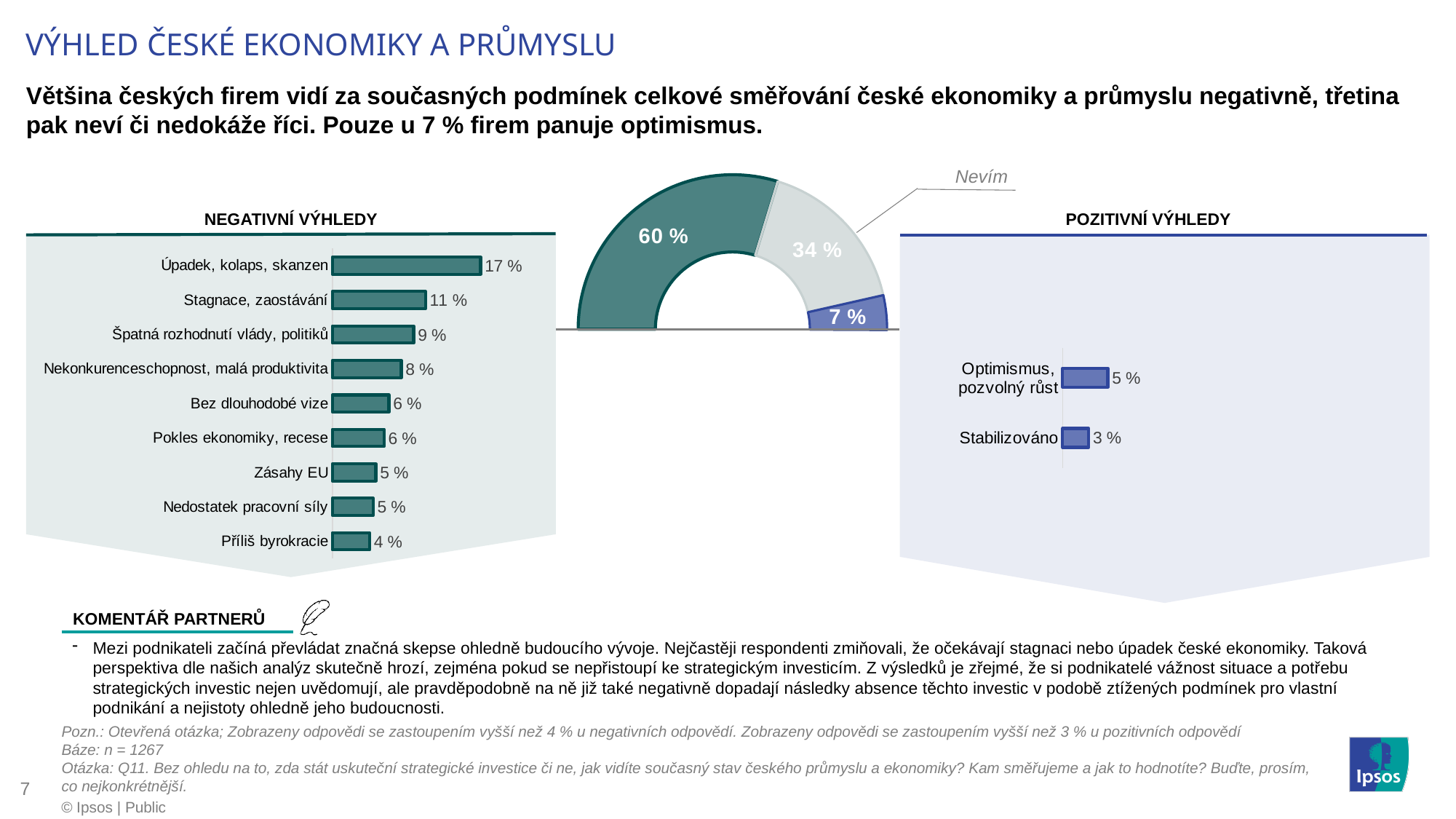
In the semicircle donut chart in the middle of the slide, what share is labelled "Nevím"? 34 % In the POZITIVNÍ VÝHLEDY bar chart, what is the value for "Stabilizováno"? 3 % In the POZITIVNÍ VÝHLEDY bar chart, how many categories are shown? 2 In the NEGATIVNÍ VÝHLEDY bar chart, what is the difference between "Úpadek, kolaps, skanzen" and "Stagnace, zaostávání"? 6 % In the NEGATIVNÍ VÝHLEDY bar chart, which category has the lowest value? Příliš byrokracie In the POZITIVNÍ VÝHLEDY bar chart, which is larger: "Optimismus, pozvolný růst" or "Stabilizováno"? Optimismus, pozvolný růst In the NEGATIVNÍ VÝHLEDY bar chart, what is the value for "Úpadek, kolaps, skanzen"? 17 % What kind of chart is used for the NEGATIVNÍ VÝHLEDY section? Bar chart In the NEGATIVNÍ VÝHLEDY bar chart, how many categories are shown? 9 In the NEGATIVNÍ VÝHLEDY bar chart, which category has the highest value? Úpadek, kolaps, skanzen In the NEGATIVNÍ VÝHLEDY bar chart, what is the value for "Stagnace, zaostávání"? 11 % In the semicircle donut chart in the middle of the slide, what is the largest segment's value? 60 %